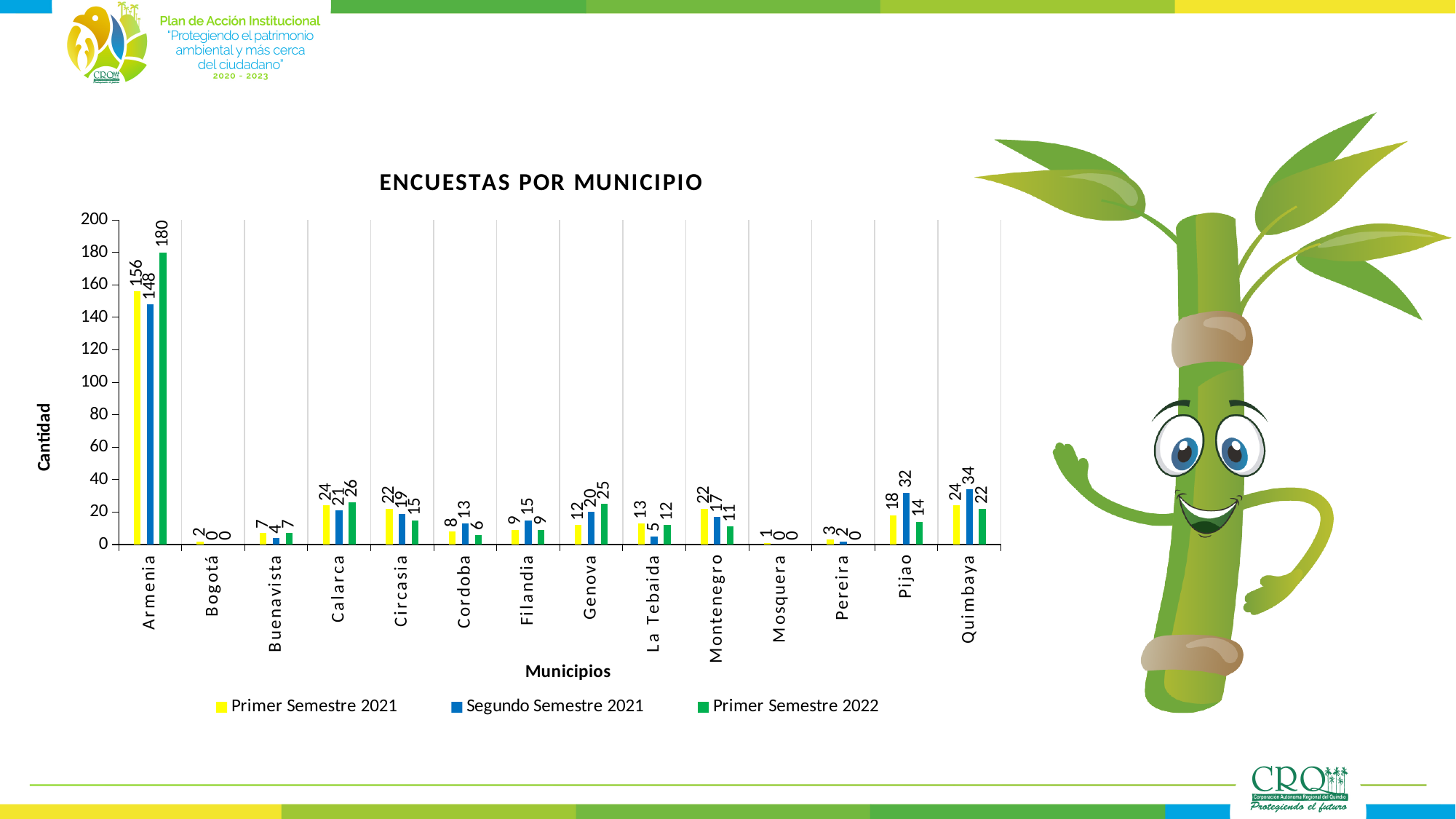
How many municipalities are shown on the x axis? 14 What is the value for Pijao in the Segundo Semestre 2021 series? 32 Which is larger for Quimbaya: the Segundo Semestre 2021 value or the Primer Semestre 2022 value? Segundo Semestre 2021 How many series does the legend list? 3 What is the title of the chart? ENCUESTAS POR MUNICIPIO What kind of chart is shown on the slide? Bar chart Which municipality has the lowest value in the Primer Semestre 2021 series? Mosquera Which municipality has the highest value in the Primer Semestre 2021 series? Armenia What is the value for Armenia in the Primer Semestre 2022 series? 180 What is the value for Genova in the Primer Semestre 2021 series? 12 Is the value for Armenia in the Segundo Semestre 2021 series greater or less than 140? greater What is the difference between the Primer Semestre 2022 and Primer Semestre 2021 values for Armenia? 24